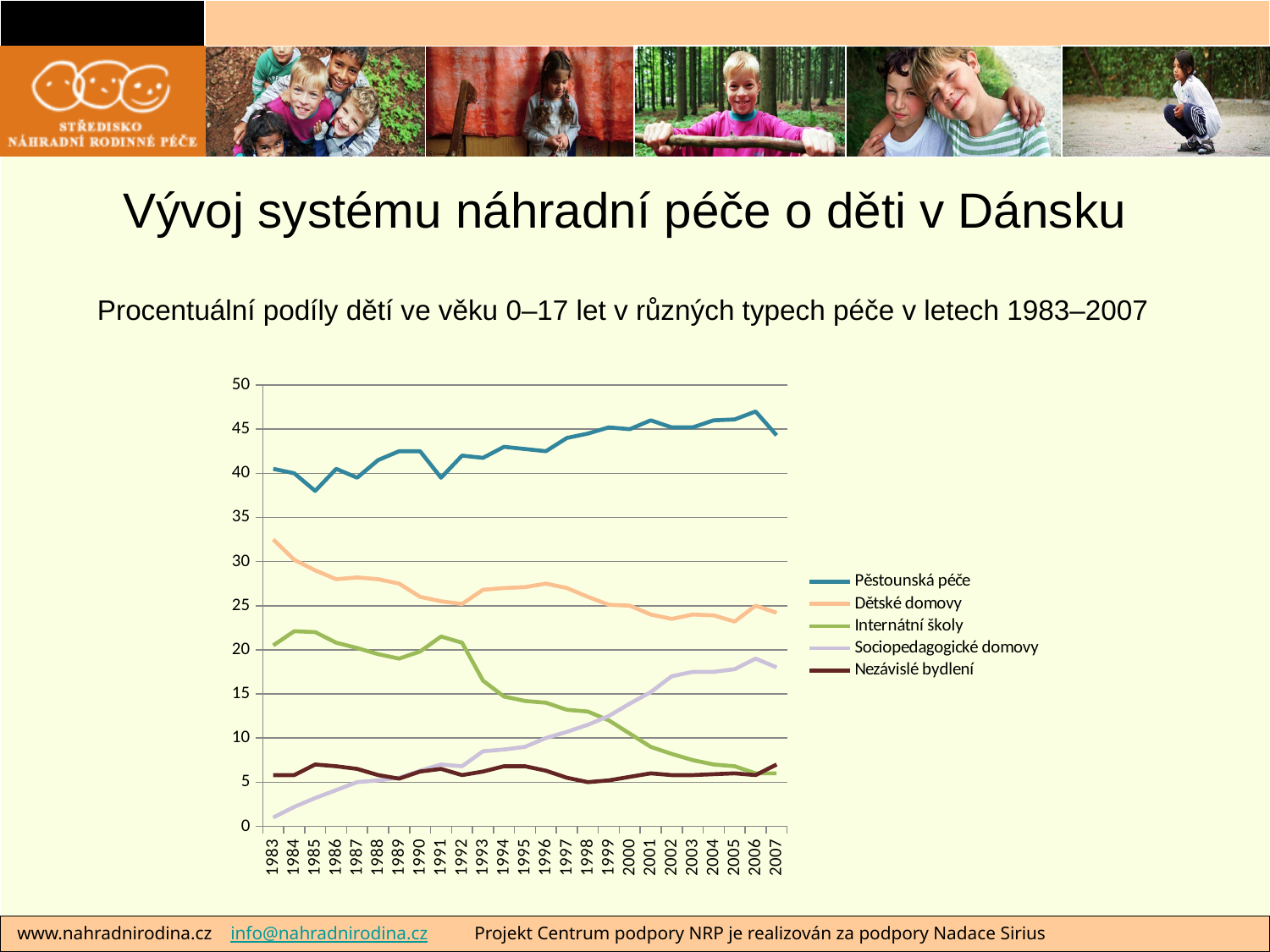
Which series has the lowest value in 1983? Sociopedagogické domovy How many series does the legend list? 5 Does the value for Dětské domovy rise or fall overall from 1983 to 2007? fall Does the value for Sociopedagogické domovy rise or fall overall from 1983 to 2007? rise Which series has the highest value in 1983? Pěstounská péče In 2007, which is higher: Sociopedagogické domovy or Internátní školy? Sociopedagogické domovy Does the value for Pěstounská péče rise or fall overall from 1983 to 2007? rise How many years are shown along the x axis? 25 Is the value for Internátní školy in 2007 greater or less than 10? less Is the value for Dětské domovy in 1983 greater or less than 30? greater Is the value for Pěstounská péče in 2006 greater or less than 45? greater What kind of chart is shown on the slide? line chart